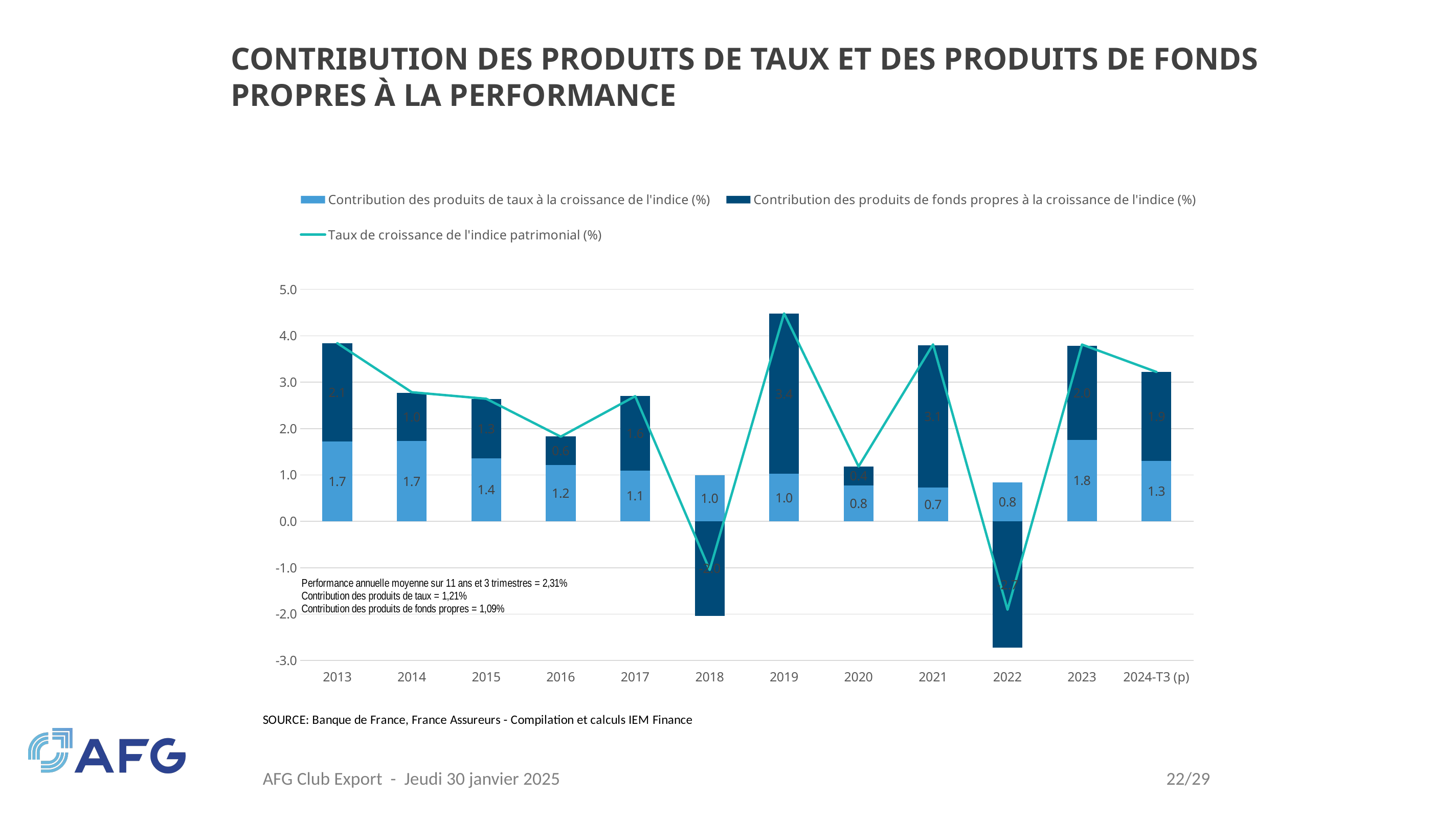
What kind of chart is shown on the slide? Stacked bar chart with a line What is the value of 'Contribution des produits de fonds propres à la croissance de l'indice (%)' for 2019? 3.4 What is the value of 'Contribution des produits de taux à la croissance de l'indice (%)' for 2013? 1.7 How many years (categories) are shown on the x axis of the chart? 12 Is the 'Taux de croissance de l'indice patrimonial (%)' line value for 2019 greater or less than 4.0? greater What is the value of 'Contribution des produits de taux à la croissance de l'indice (%)' for 2021? 0.7 What is the difference between the 'Contribution des produits de taux' values for 2023 and 2021? 1.1 How many series does the chart legend list? 3 Which year has the highest value for 'Contribution des produits de taux à la croissance de l'indice (%)'? 2023 Which year has the lowest value for 'Contribution des produits de taux à la croissance de l'indice (%)'? 2021 Which year has the larger 'Contribution des produits de taux' value, 2015 or 2016? 2015 Is the 'Taux de croissance de l'indice patrimonial (%)' line value for 2022 greater or less than -1.0? less